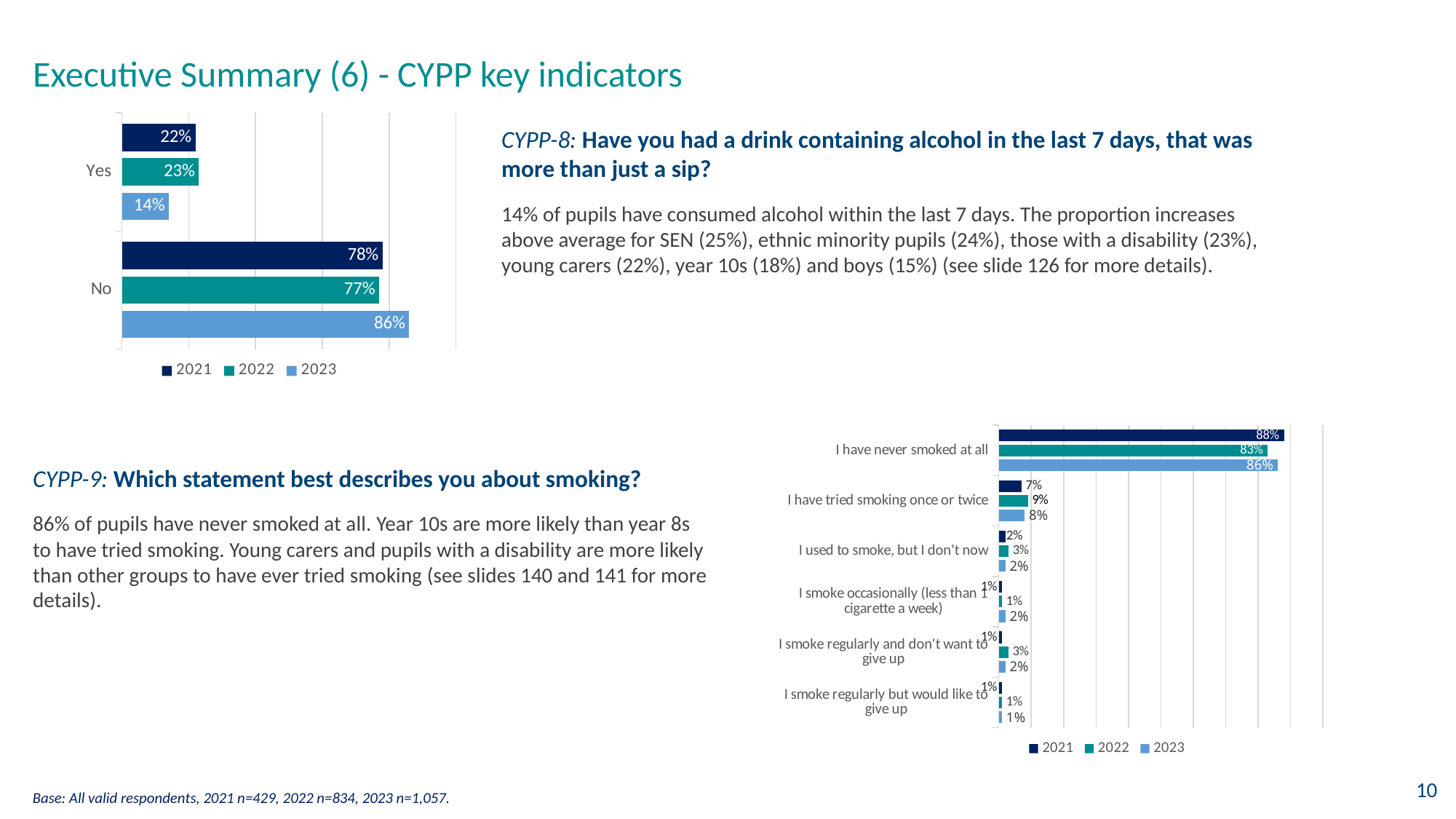
In the bottom-right chart (smoking statements), how many statement categories are shown? 6 In the bottom-right chart (smoking statements), which statement has the highest value in 2021? I have never smoked at all In the top-left chart (alcohol in the last 7 days), what is the 2021 value for No? 78% In the top-left chart (alcohol in the last 7 days), how many series does the legend list? 3 What kind of chart is the top-left chart (alcohol in the last 7 days)? Bar chart In the bottom-right chart (smoking statements), what is the 2023 value for 'I have tried smoking once or twice'? 8% In the bottom-right chart (smoking statements), what is the 2022 value for 'I have never smoked at all'? 83% In the bottom-right chart (smoking statements), is the 2021 value for 'I have never smoked at all' larger or smaller than the 2023 value? Larger In the top-left chart (alcohol in the last 7 days), what is the 2023 value for Yes? 14% In the top-left chart (alcohol in the last 7 days), what is the difference between the 2022 and 2023 values for Yes? 9% In the top-left chart (alcohol in the last 7 days), which year has the highest value for No? 2023 In the bottom-right chart (smoking statements), what is the difference between the 2022 and 2021 values for 'I have tried smoking once or twice'? 2%